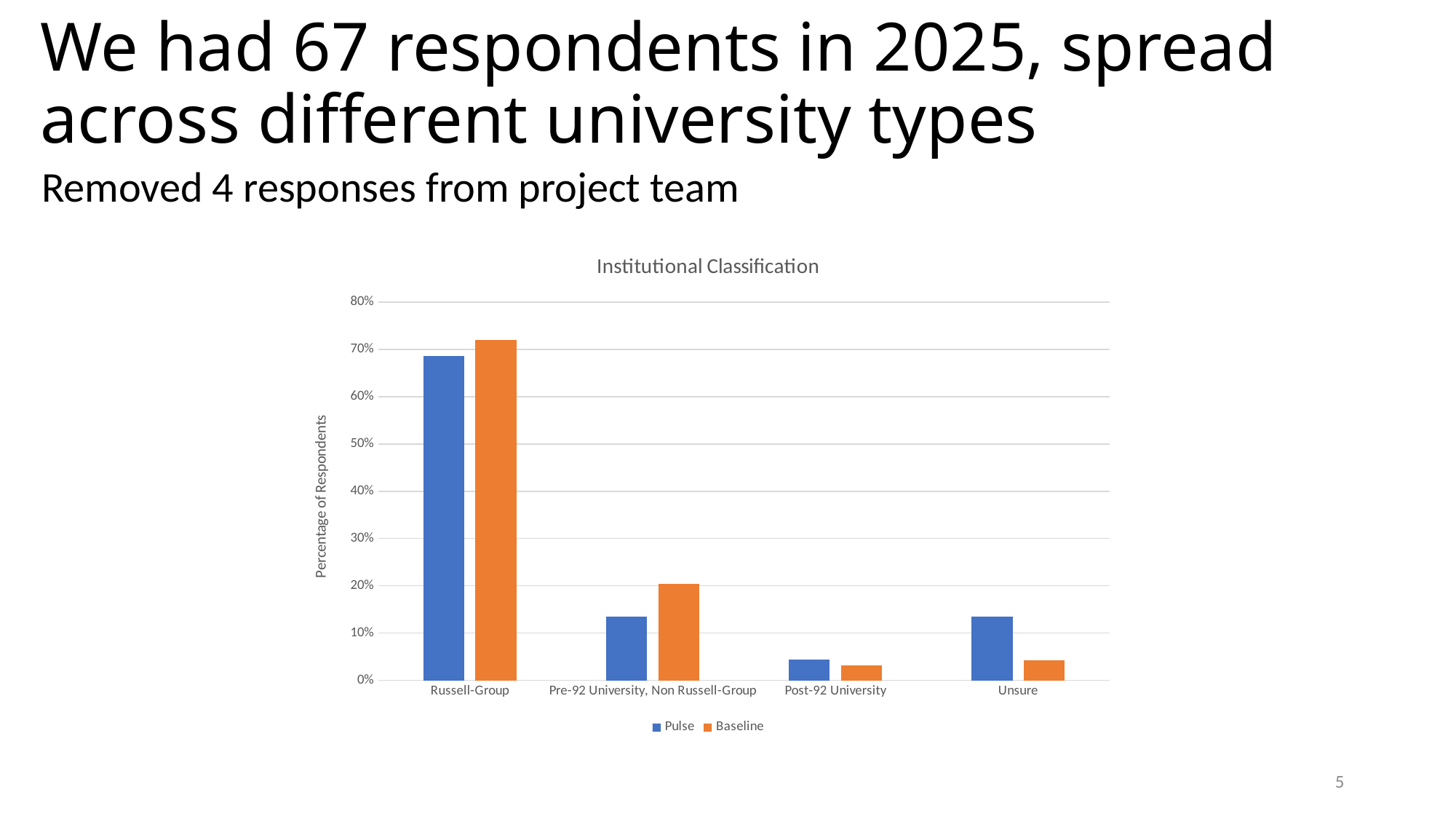
Which category has the lowest Pulse value? Post-92 University Is the Pulse value for Post-92 University greater or less than 10%? less How many series does the legend list? 2 Is the Baseline value for Pre-92 University, Non Russell-Group greater or less than 10%? greater What is the label on the vertical axis of the chart? Percentage of Respondents Is the Pulse value for Russell-Group greater or less than 60%? greater How many institution categories are shown on the x axis? 4 Which category has the highest Pulse value? Russell-Group What type of chart is shown on the slide? Bar chart For Unsure, which series has the larger value, Pulse or Baseline? Pulse What is the title of the chart? Institutional Classification For Russell-Group, which series has the larger value, Pulse or Baseline? Baseline